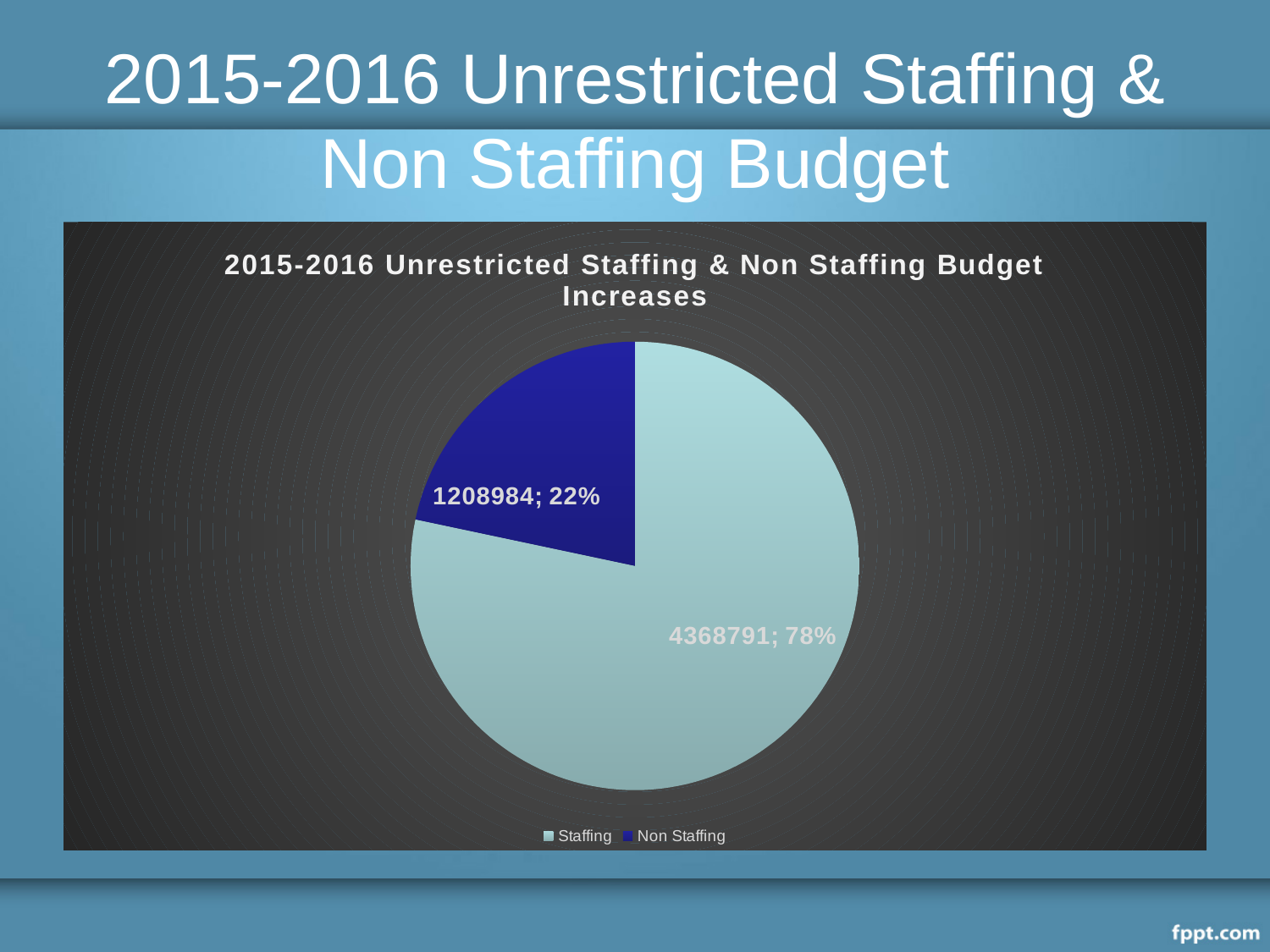
What share of the pie does Non Staffing represent? 22% How many categories are shown in the pie chart? 2 Which is larger, Staffing or Non Staffing? Staffing What share of the pie does Staffing represent? 78% Which category has the smallest slice? Non Staffing What colour is the Non Staffing slice? dark blue Which category has the largest slice? Staffing What is the title of the chart? 2015-2016 Unrestricted Staffing & Non Staffing Budget Increases What is the difference between the Staffing and Non Staffing values? 3159807 What type of chart is shown on the slide? pie chart What is the value for Non Staffing? 1208984 What is the value for Staffing? 4368791